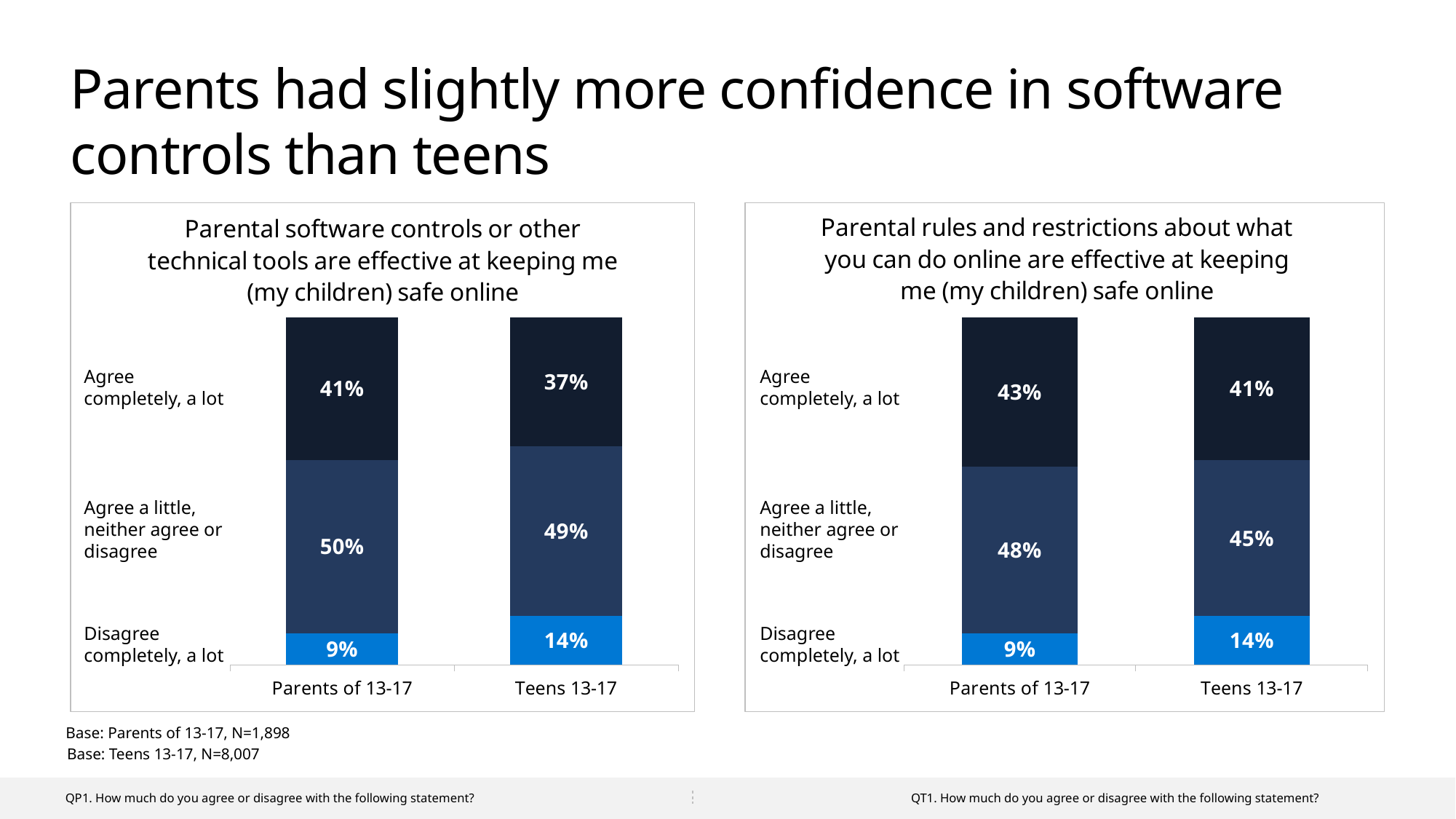
In the left chart (Parental software controls), what is the total of the stacked bar for Teens 13-17? 100% In the right chart (Parental rules and restrictions), which group has the larger 'Disagree completely, a lot' value, Parents of 13-17 or Teens 13-17? Teens 13-17 In the left chart (Parental software controls), which group has the larger 'Agree a little, neither agree or disagree' value, Parents of 13-17 or Teens 13-17? Parents of 13-17 In the right chart (Parental rules and restrictions), what percentage of Teens 13-17 'Agree a little, neither agree or disagree'? 45% In the left chart (Parental software controls), what percentage of Parents of 13-17 'Agree completely, a lot'? 41% In the left chart (Parental software controls), what is the difference between the 'Agree completely, a lot' values for Parents of 13-17 and Teens 13-17? 4% How many segments (response categories) make up each stacked bar in the left chart (Parental software controls)? 3 What type of chart is used in the left chart (Parental software controls)? Stacked bar chart In the right chart (Parental rules and restrictions), what percentage of Parents of 13-17 'Agree completely, a lot'? 43% In the right chart (Parental rules and restrictions), what is the difference between the 'Disagree completely, a lot' values for Teens 13-17 and Parents of 13-17? 5% In the left chart (Parental software controls), what percentage of Teens 13-17 'Disagree completely, a lot'? 14% How many bars are shown in the right chart (Parental rules and restrictions)? 2